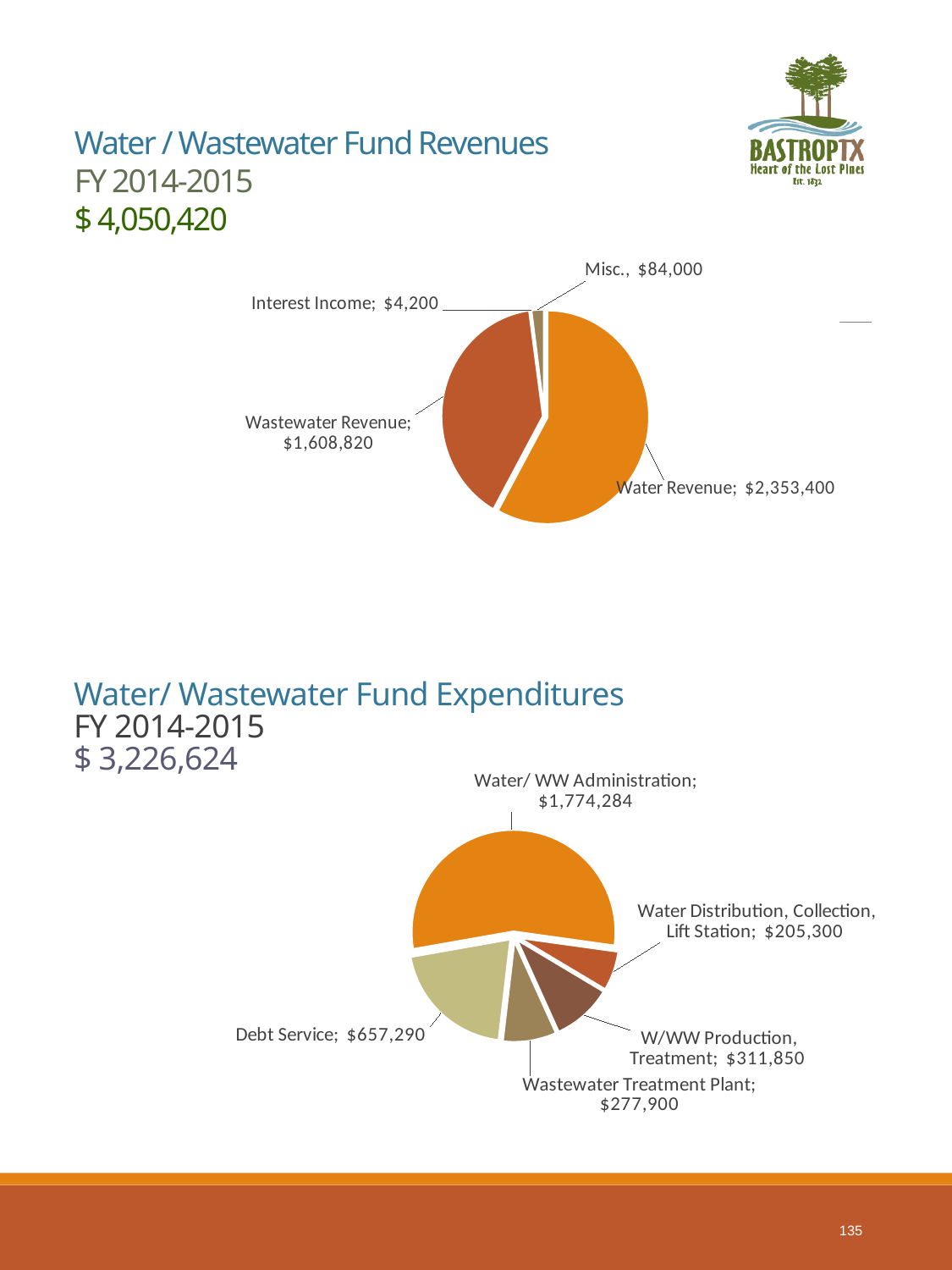
On the Water/ Wastewater Fund Expenditures chart, what is the value for Debt Service? $657,290 On the Water / Wastewater Fund Revenues chart, how many categories are shown? 4 On the Water / Wastewater Fund Revenues chart, how much larger is Water Revenue than Wastewater Revenue? $744,580 On the Water/ Wastewater Fund Expenditures chart, what is the value for Water Distribution, Collection, Lift Station? $205,300 On the Water/ Wastewater Fund Expenditures chart, how many categories are shown? 5 On the Water/ Wastewater Fund Expenditures chart, which is larger: W/WW Production, Treatment or Wastewater Treatment Plant? W/WW Production, Treatment On the Water/ Wastewater Fund Expenditures chart, which category is the largest? Water/ WW Administration On the Water / Wastewater Fund Revenues chart, which category is the largest? Water Revenue On the Water / Wastewater Fund Revenues chart, which category is the smallest? Interest Income On the Water / Wastewater Fund Revenues chart, what is the value for Water Revenue? $2,353,400 On the Water / Wastewater Fund Revenues chart, what is the value for Interest Income? $4,200 What kind of chart is used for the Water / Wastewater Fund Revenues? Pie chart